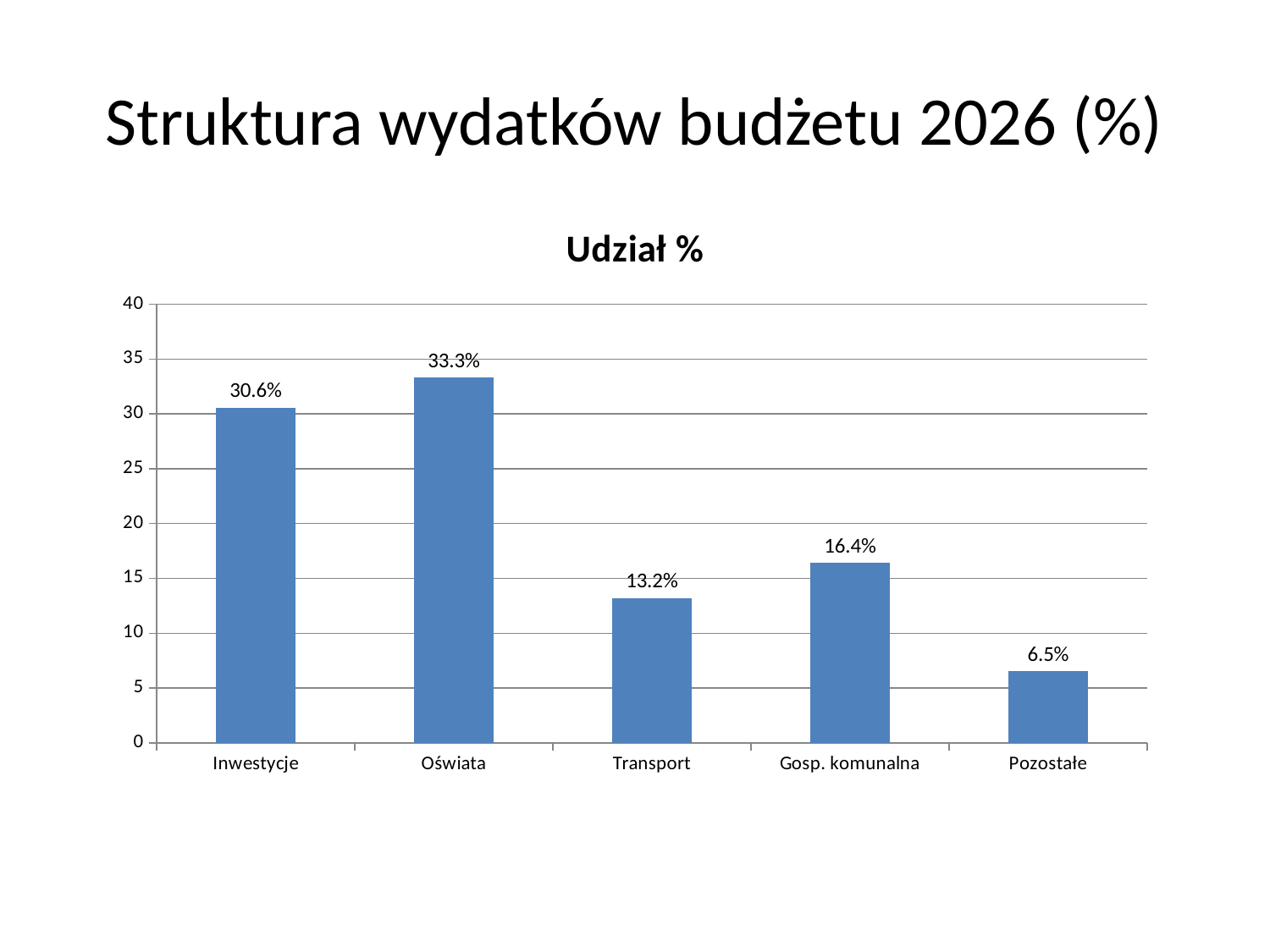
Which is larger, the value for Transport or the value for Gosp. komunalna? Gosp. komunalna What is the difference between the values for Oświata and Inwestycje? 2.7% Is the value for Inwestycje greater or less than 25? greater What is the value for Pozostałe? 6.5% What is the value for Transport? 13.2% Which category has the highest value? Oświata Which category has the lowest value? Pozostałe What is the value for Inwestycje? 30.6% How many categories are shown on the chart? 5 What is the value for Gosp. komunalna? 16.4% What kind of chart is shown on the slide? bar chart What is the value for Oświata? 33.3%